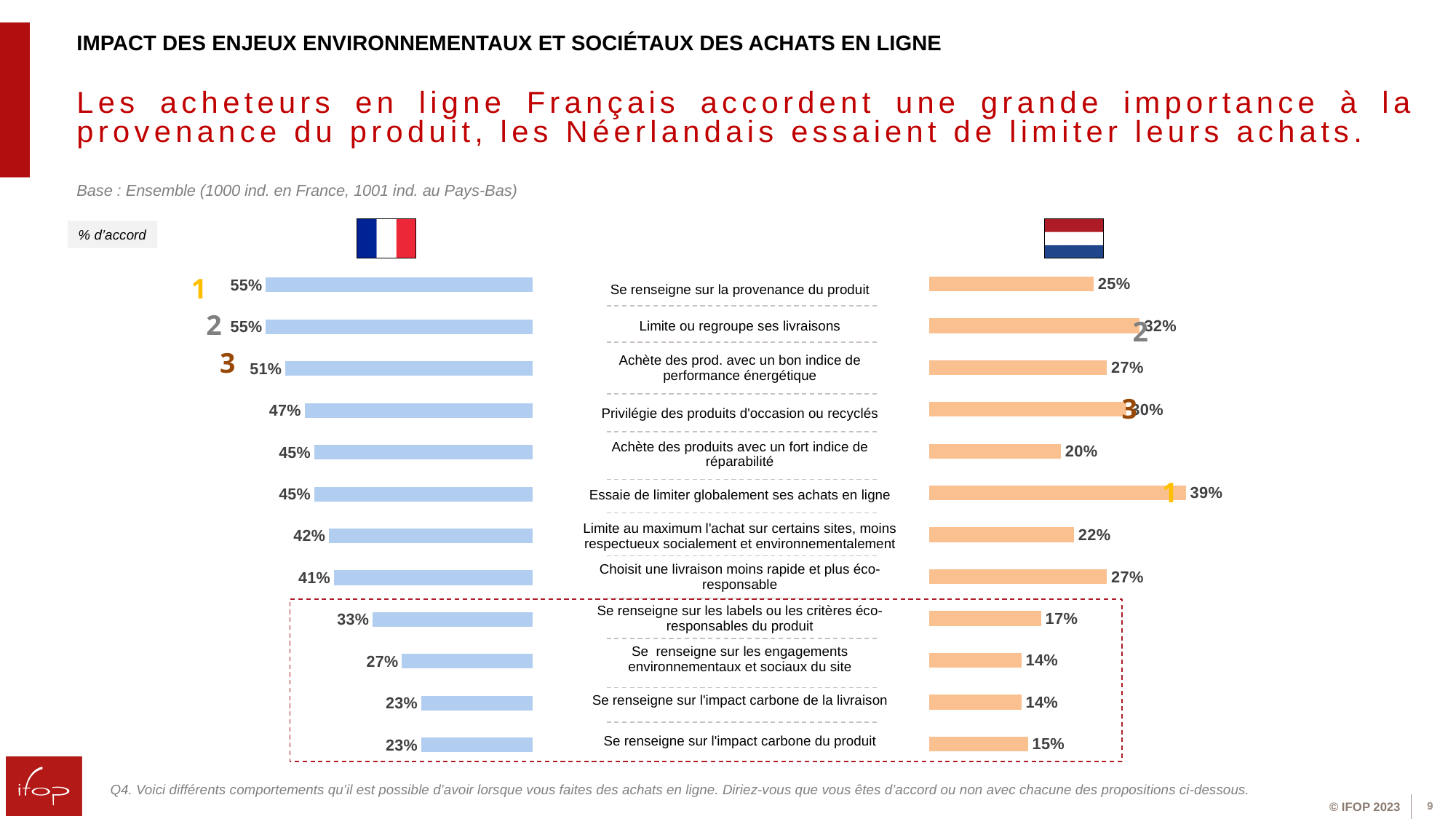
In the France chart (left), what is the value for "Se renseigne sur les labels ou les critères éco-responsables du produit"? 33% For "Privilégie des produits d'occasion ou recyclés", which country has the higher value, France or the Netherlands? France In the France chart (left), do the values rise or fall from the top category to the bottom category? Fall In the Netherlands chart (right), what is the lowest percentage shown? 14% In the Netherlands chart (right), what is the value for "Limite ou regroupe ses livraisons"? 32% What type of chart is used to show the France results? Bar chart What is the difference between the France value and the Netherlands value for "Se renseigne sur la provenance du produit"? 30 points In the Netherlands chart (right), what percentage agree with "Essaie de limiter globalement ses achats en ligne"? 39% In the France chart (left), what percentage agree with "Se renseigne sur la provenance du produit"? 55% In the France chart (left), what is the difference between the value for "Limite ou regroupe ses livraisons" and the value for "Se renseigne sur l'impact carbone du produit"? 32 points In the Netherlands chart (right), which behaviour has the highest percentage of agreement? Essaie de limiter globalement ses achats en ligne How many behaviours (categories) are listed in the charts? 12